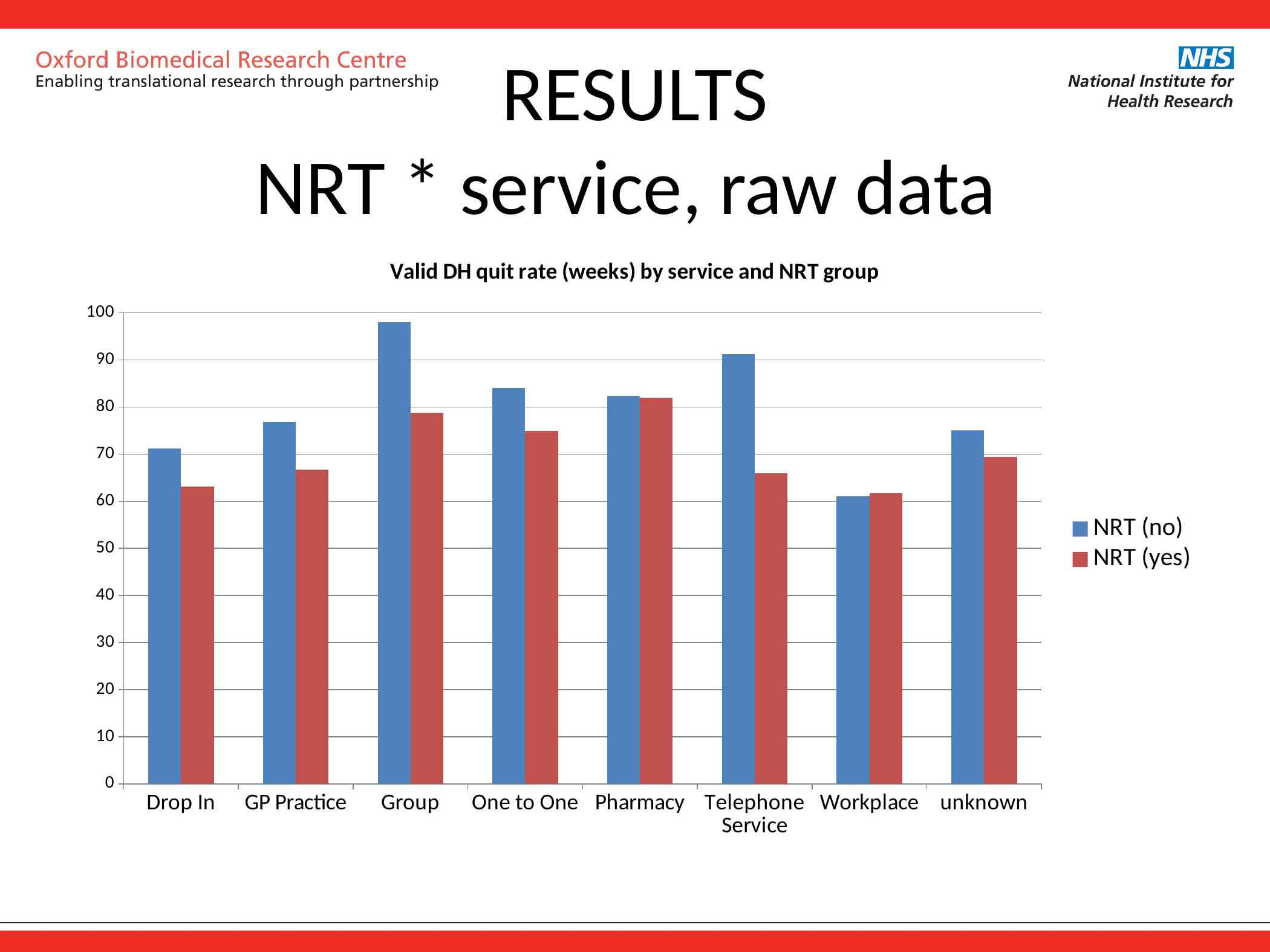
How many service categories are shown on the x axis? 8 What kind of chart is shown on the slide? bar chart Which service has the lowest value for NRT (no)? Workplace Which colour represents the NRT (no) series? blue What is the title of the chart? Valid DH quit rate (weeks) by service and NRT group Is the NRT (yes) value for Drop In greater or less than 70? less Which service has the highest value for NRT (no)? Group For Telephone Service, which is larger: NRT (no) or NRT (yes)? NRT (no) How many series does the legend list? 2 Is the NRT (no) value for Telephone Service greater or less than 80? greater Is the NRT (no) value for Group greater or less than 90? greater For Group, which is larger: NRT (no) or NRT (yes)? NRT (no)